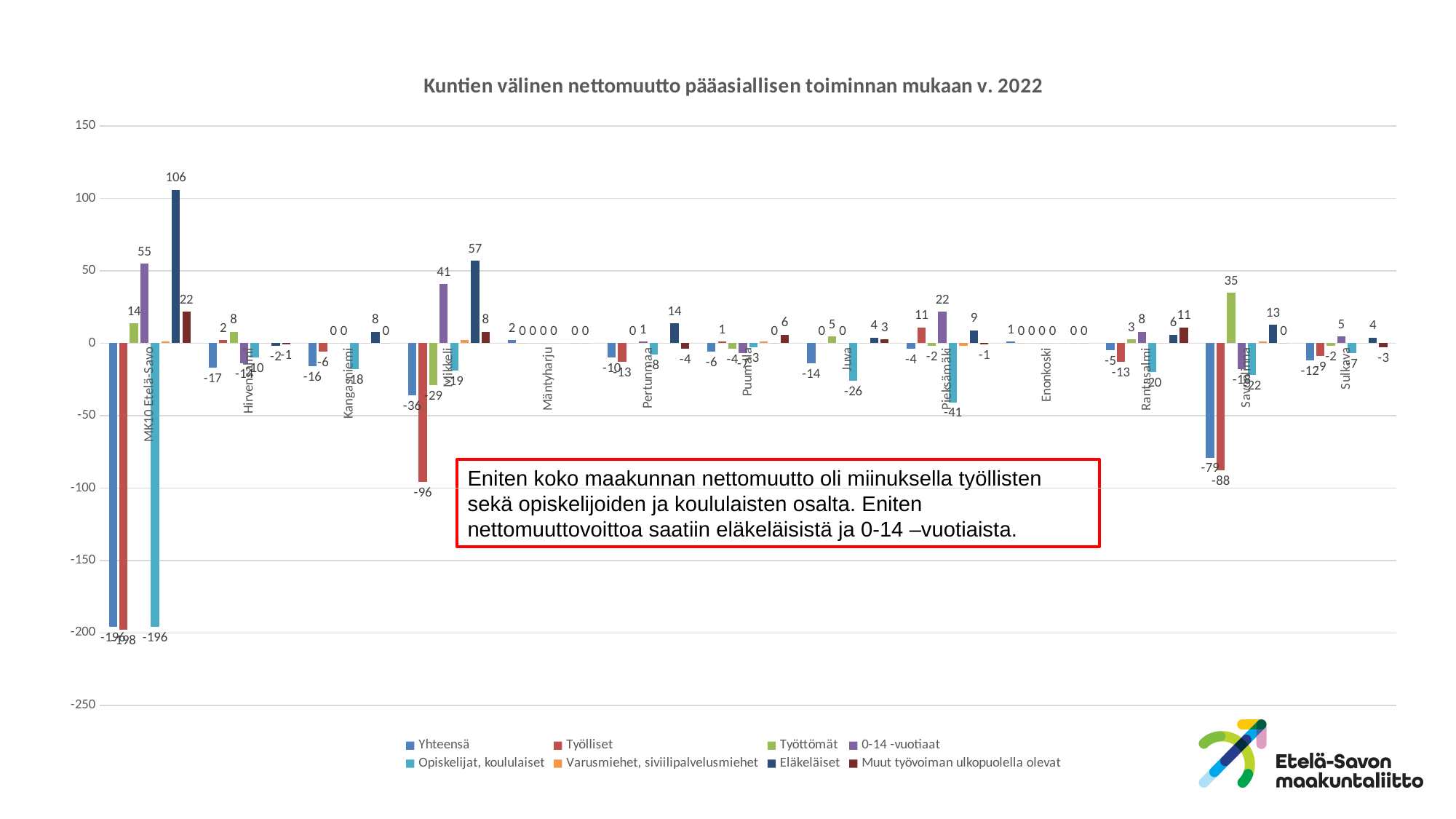
How many series does the legend list? 8 What is the Eläkeläiset value for MK10 Etelä-Savo? 106 What kind of chart is shown on the slide? bar chart What is the Opiskelijat, koululaiset value for Pieksämäki? -41 What is the Työlliset value for Mikkeli? -96 What is the Työttömät value for Savonlinna? 35 How many categories (areas) are shown on the x axis? 13 What is the 0-14 -vuotiaat value for Mikkeli? 41 Which category has the highest Eläkeläiset value? MK10 Etelä-Savo What is the difference between the Eläkeläiset value for MK10 Etelä-Savo and for Mikkeli? 49 Which category has the lowest Opiskelijat, koululaiset value? MK10 Etelä-Savo Which is larger, the Eläkeläiset value for Mikkeli or for Savonlinna? Mikkeli